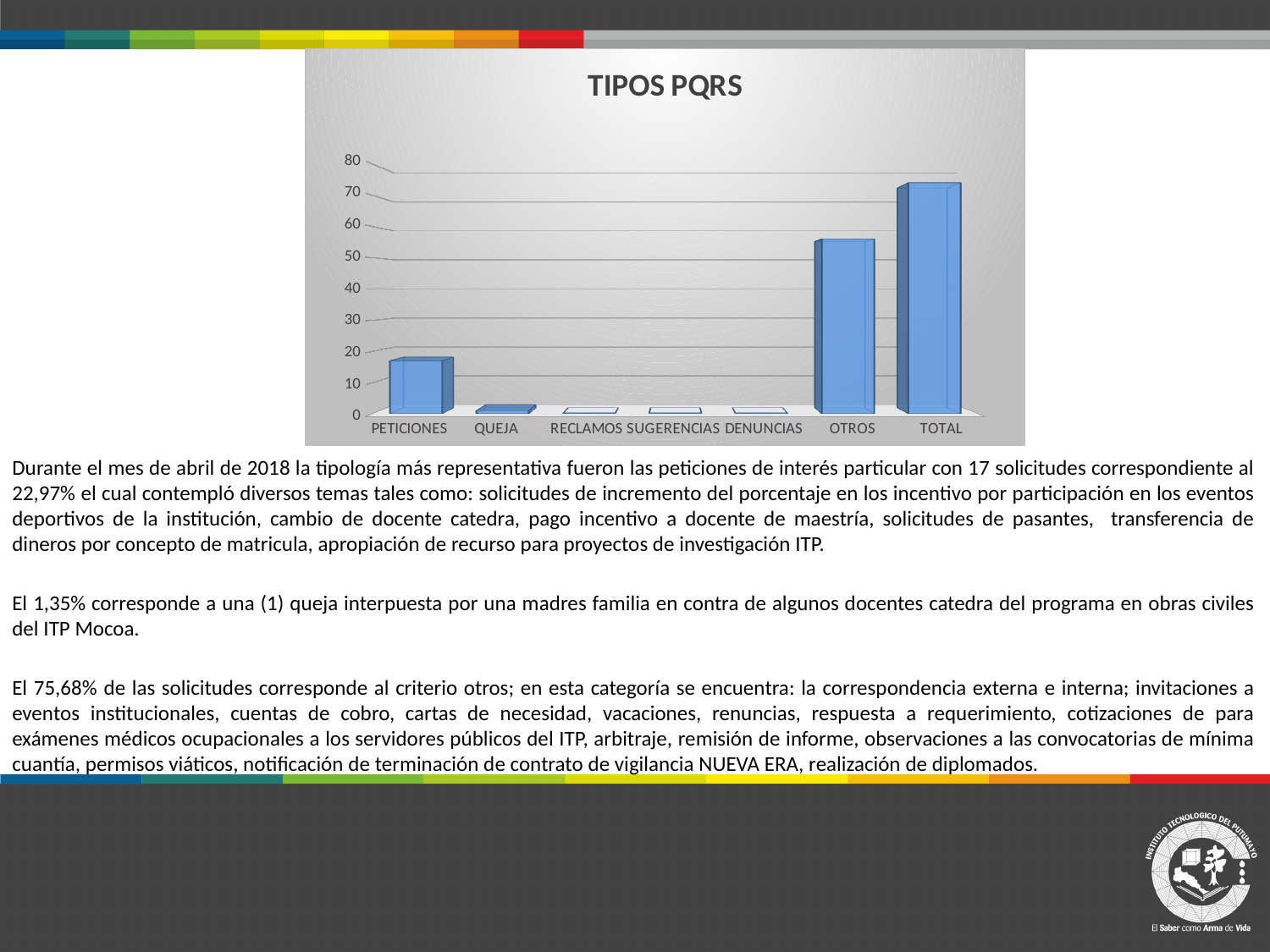
What type of chart is shown on the slide? bar chart Excluding TOTAL, which category has the highest bar? OTROS What is the title of the chart? TIPOS PQRS Which category has the highest bar in the chart? TOTAL How many categories are shown on the x axis of the chart? 7 Which is larger, the bar for OTROS or the bar for PETICIONES? OTROS What is the highest value shown on the vertical axis of the chart? 80 Is the value for PETICIONES greater or less than 20? less Which is larger, the bar for PETICIONES or the bar for QUEJA? PETICIONES Is the value for TOTAL greater or less than 70? greater Is the value for OTROS greater or less than 50? greater